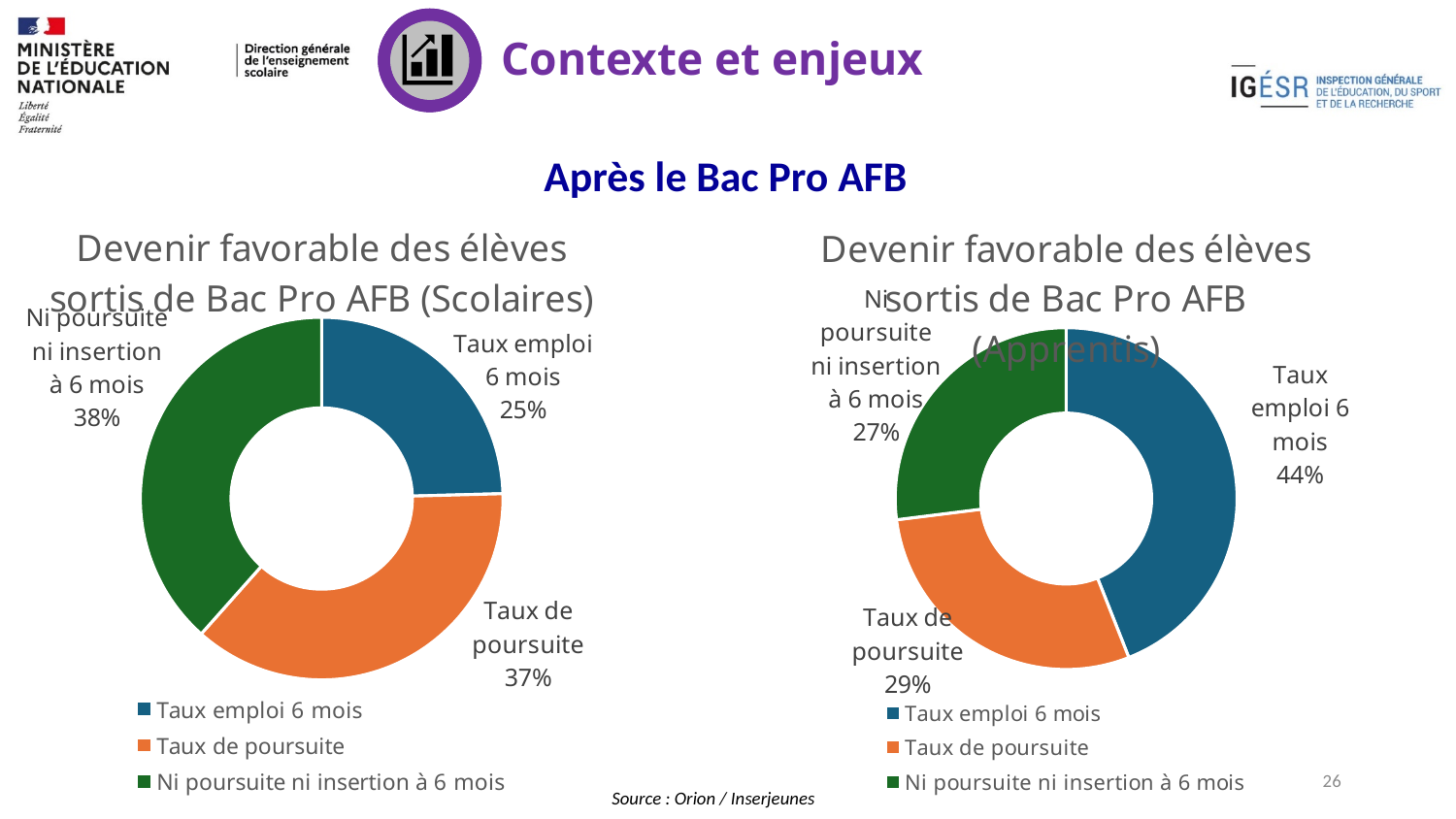
In the right chart (Apprentis), what is the value for Ni poursuite ni insertion à 6 mois? 27% What is the difference between Taux emploi 6 mois in the right chart (Apprentis) and in the left chart (Scolaires)? 19 percentage points In the right chart (Apprentis), what is the value for Taux emploi 6 mois? 44% What kind of chart is the right chart (Apprentis)? Doughnut chart In the right chart (Apprentis), which category has the largest share? Taux emploi 6 mois In the left chart (Scolaires), what is the value for Taux emploi 6 mois? 25% Is Taux de poursuite larger in the left chart (Scolaires) or in the right chart (Apprentis)? Left chart (Scolaires) In the right chart (Apprentis), what is the value for Taux de poursuite? 29% In the left chart (Scolaires), what is the value for Ni poursuite ni insertion à 6 mois? 38% In the left chart (Scolaires), which category has the smallest share? Taux emploi 6 mois In the left chart (Scolaires), what is the value for Taux de poursuite? 37% How many categories does the left chart (Scolaires) show? 3